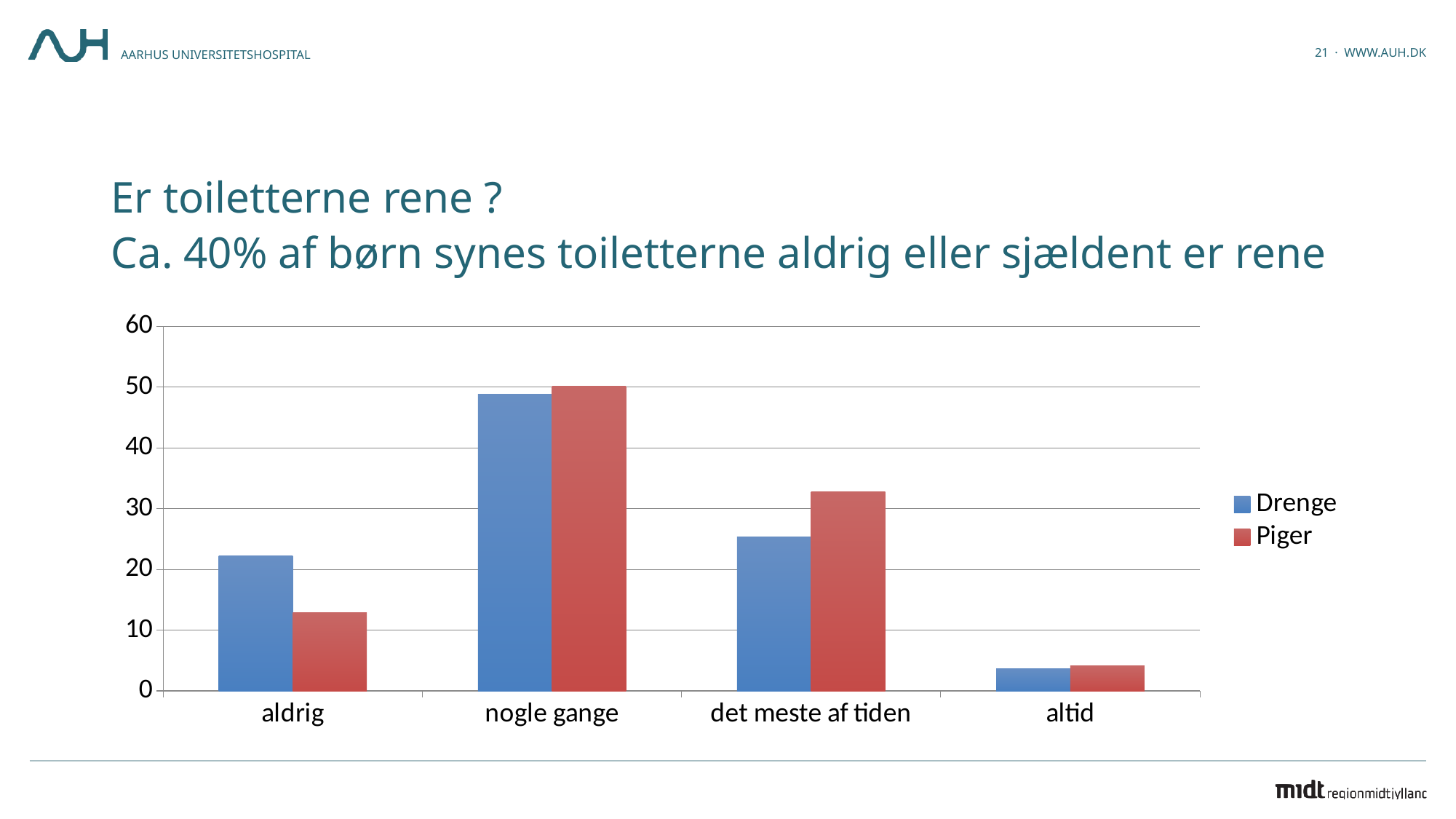
Is the value for Drenge in 'aldrig' greater or less than 20? greater Which category has the highest value for Piger? nogle gange Is the value for Piger in 'aldrig' greater or less than 20? less What kind of chart is shown on the slide? bar chart For the category 'aldrig', which series has the larger value, Drenge or Piger? Drenge How many categories are shown on the x axis? 4 Is the value for Piger in 'det meste af tiden' greater or less than 30? greater What are the two series named in the legend? Drenge and Piger How many series does the legend list? 2 Which category has the lowest value for Piger? altid For the category 'det meste af tiden', which series has the larger value, Drenge or Piger? Piger Which category has the highest value for Drenge? nogle gange